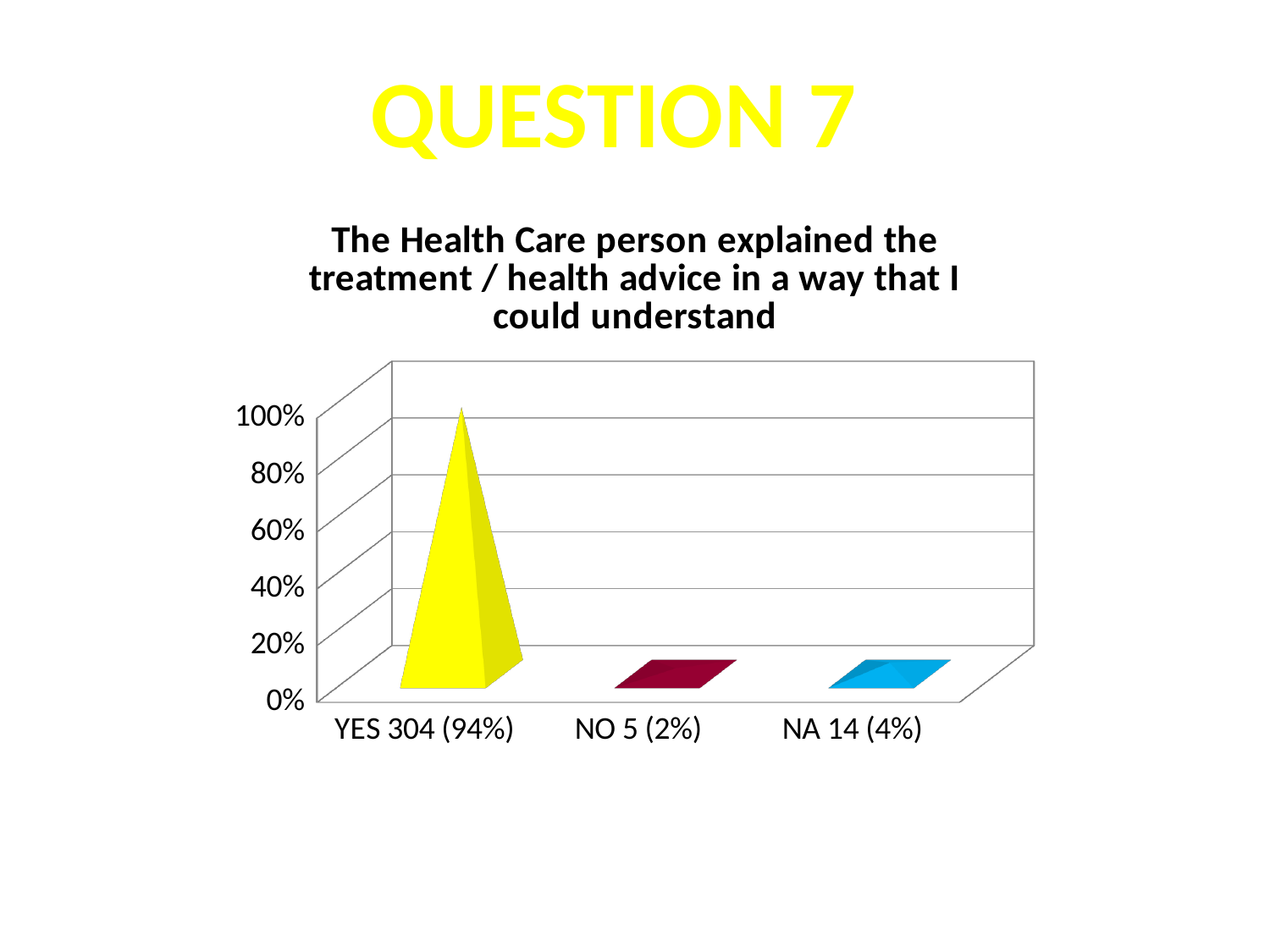
What kind of chart is shown on the slide? bar chart What is the difference in percentage points between YES and NA? 90 How many respondents answered NO? 5 Is the value for YES greater or less than 80%? greater What percentage of respondents answered NA? 4% What is the total number of respondents across YES, NO and NA? 323 Which category has the lowest value? NO Which is larger, the value for NO or the value for NA? NA Which category has the highest value? YES What colour is the bar for YES? yellow What percentage of respondents answered YES? 94% How many categories are shown on the x axis? 3